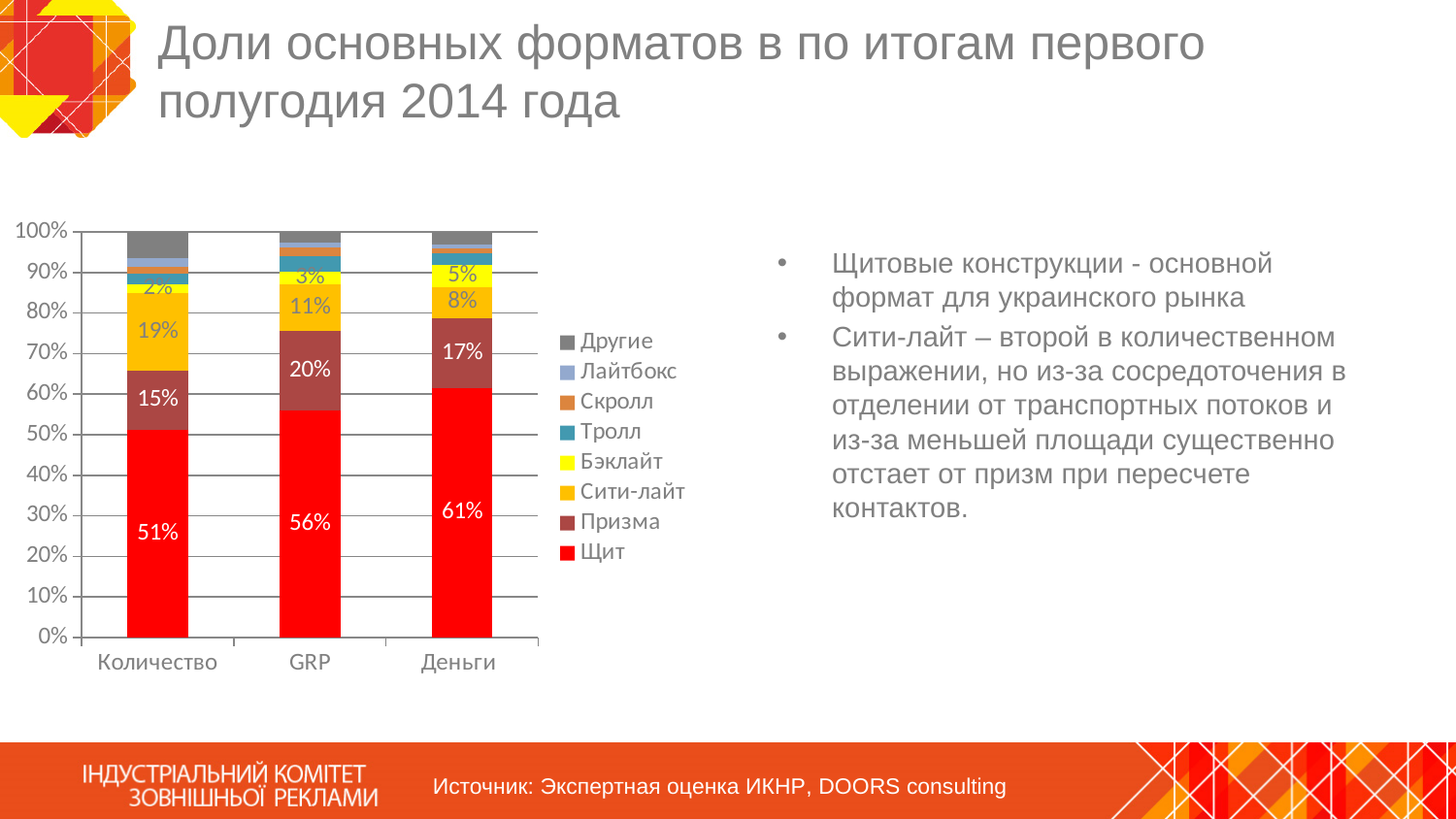
Which is larger: the Сити-лайт share for GRP or the Сити-лайт share for Деньги? GRP What is the value of Призма for the GRP category? 20% What is the difference between the Щит share for Деньги and for Количество? 10% What is the value of Сити-лайт for the Количество category? 19% How many categories are shown on the x axis of the chart? 3 How many series does the chart legend list? 8 What is the value of Щит for the Деньги category? 61% What is the value of Бэклайт for the Деньги category? 5% In which category is the Сити-лайт share the lowest? Деньги What is the value of Щит for the Количество category? 51% In which category is the Щит share the highest? Деньги What kind of chart is shown on the slide? Stacked bar chart